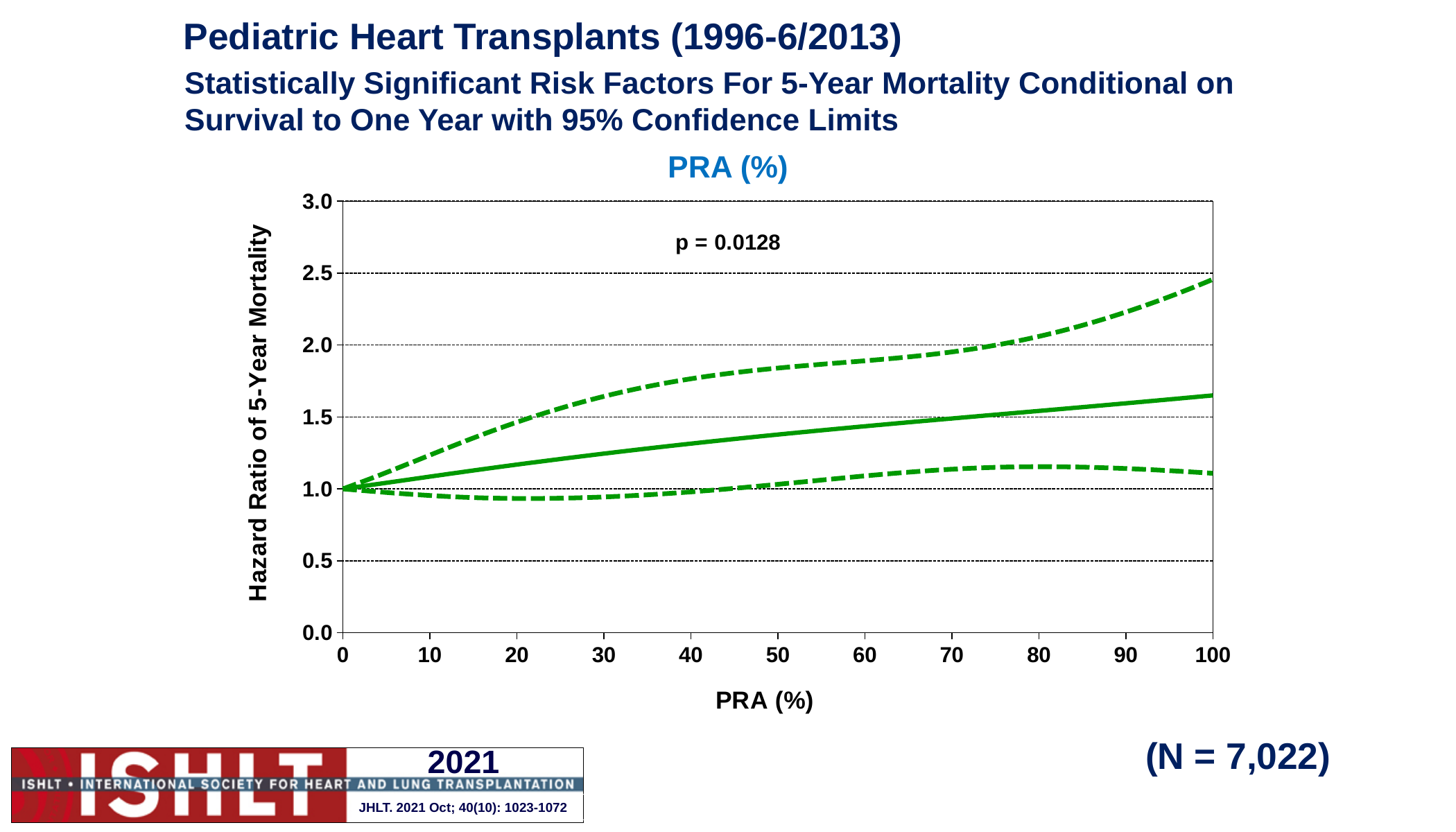
Is the value of the solid hazard ratio line at PRA 100% greater or less than 1.5? greater What is the label of the y axis? Hazard Ratio of 5-Year Mortality What kind of chart is shown on the slide? line chart Is the value of the upper dashed confidence limit at PRA 50% greater or less than 1.5? greater Is the value of the solid hazard ratio line at PRA 50% greater or less than 1.5? less What is the highest value shown on the y axis? 3.0 What is the hazard ratio of the solid line at PRA 0%? 1.0 What is the title of the chart? PRA (%) Does the solid hazard ratio line rise or fall as PRA increases from 0 to 100? rise How many lines are plotted on the chart? 3